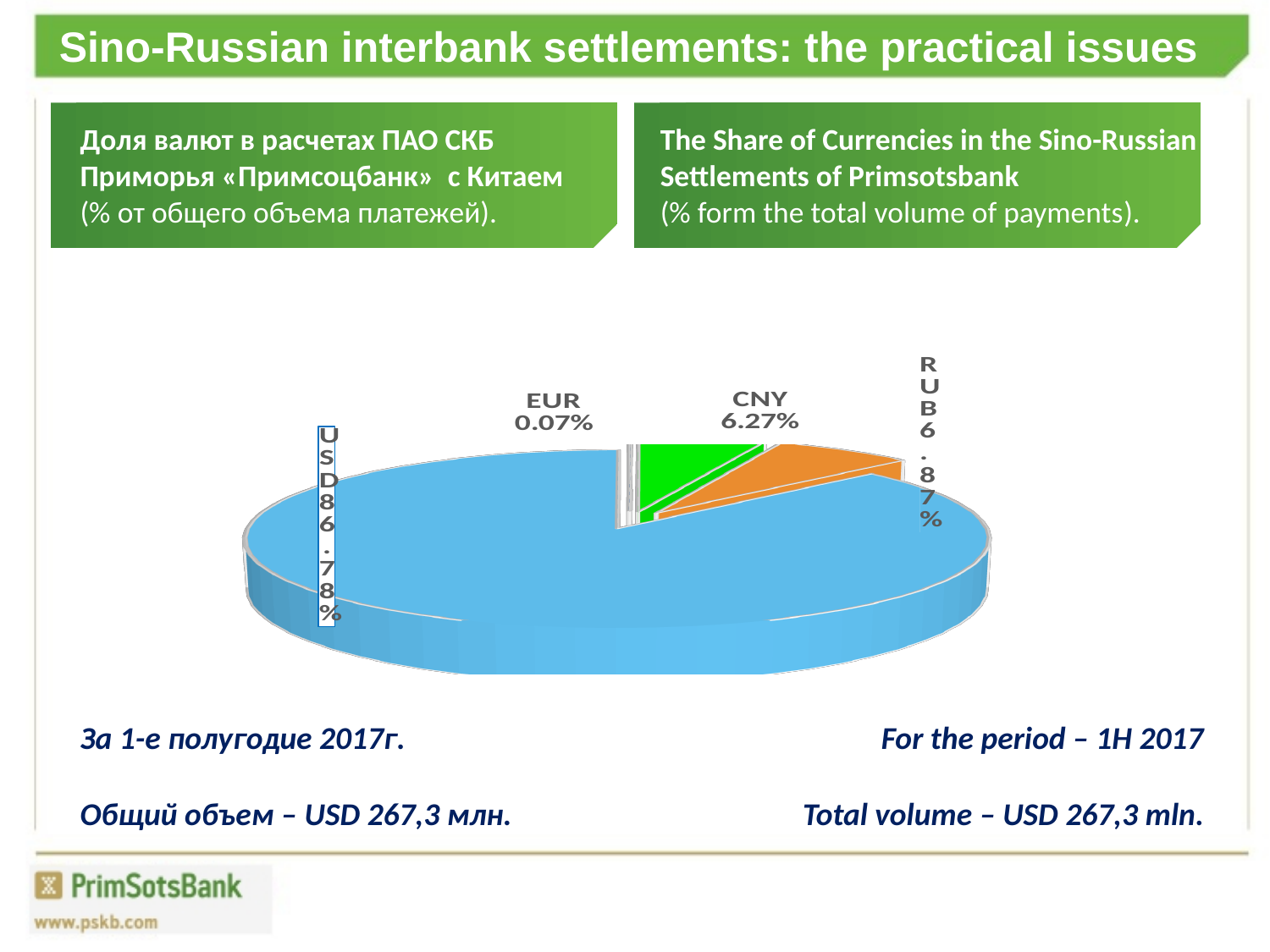
What share of the settlements is in USD? 86.78% What share of the settlements is in EUR? 0.07% What colour is the USD slice of the pie chart? blue What is the difference between the RUB share and the CNY share? 0.60% What kind of chart is shown on the slide? pie chart What share of the settlements is in RUB? 6.87% Which currency has the largest share of the settlements? USD What share of the settlements is in CNY? 6.27% What is the difference between the USD share and the RUB share? 79.91% Which is larger, the share of RUB or the share of CNY? RUB How many currencies are shown in the pie chart? 4 Which currency has the smallest share of the settlements? EUR